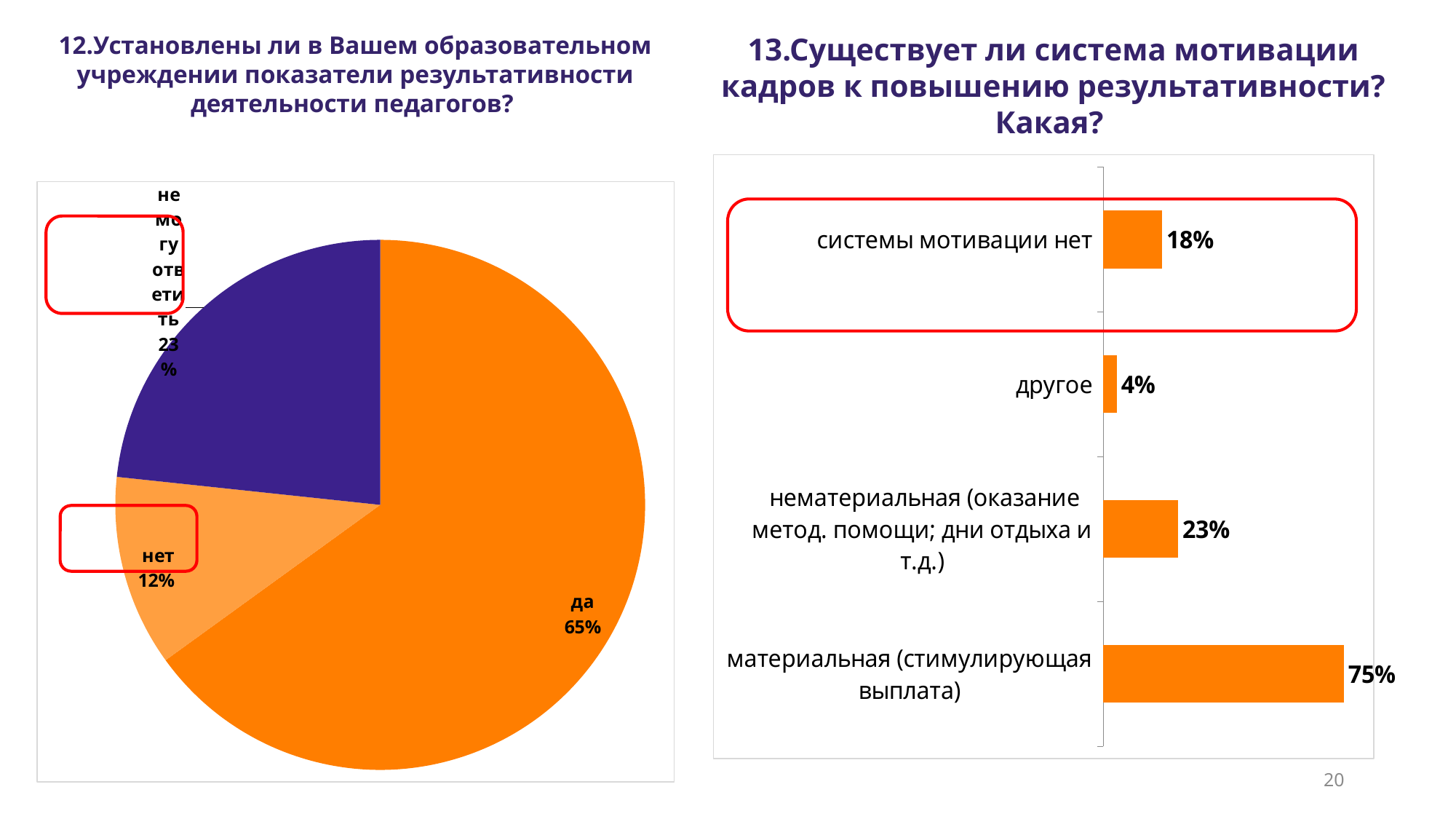
In the bar chart on the right, what is the difference between the values for "материальная (стимулирующая выплата)" and "нематериальная (оказание метод. помощи; дни отдыха и т.д.)"? 52% What type of chart is shown on the right side of the slide? bar chart In the bar chart on the right, which is larger: the value for "системы мотивации нет" or the value for "нематериальная (оказание метод. помощи; дни отдыха и т.д.)"? нематериальная (оказание метод. помощи; дни отдыха и т.д.) In the pie chart on the left, which answer has the largest share? да In the pie chart on the left, what share of respondents answered "не могу ответить"? 23% In the bar chart on the right, which category has the lowest value? другое In the pie chart on the left, what share of respondents answered "да"? 65% In the pie chart on the left, how many slices are there? 3 In the bar chart on the right, what is the value for "системы мотивации нет"? 18% In the pie chart on the left, what share of respondents answered "нет"? 12% In the pie chart on the left, which answer has the smallest share? нет In the bar chart on the right, what is the value for "материальная (стимулирующая выплата)"? 75%